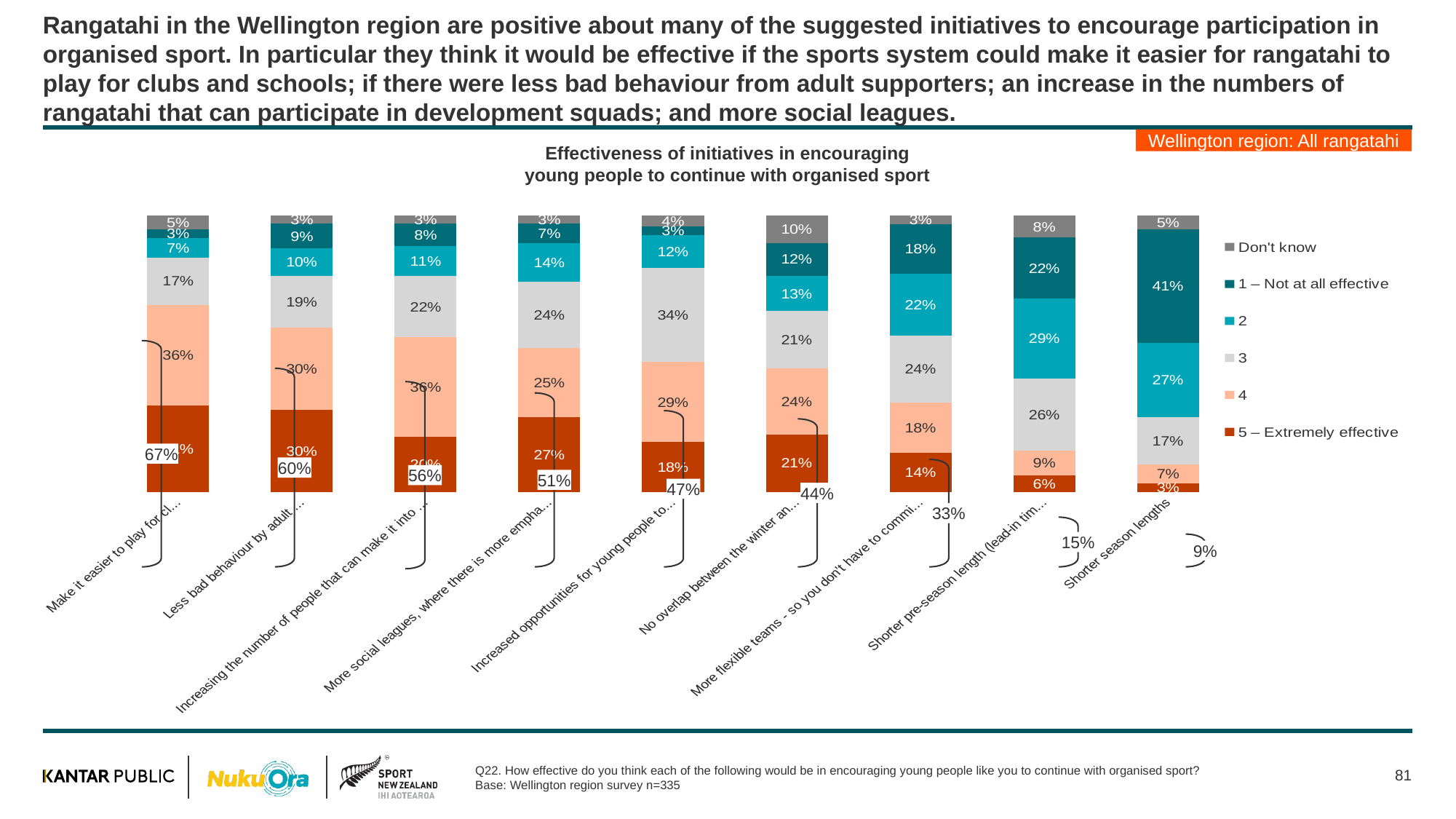
What is the value for rating '3' in the bar labelled 'Increased opportunities for young people to...'? 34% What is the value for rating '2' in the 'Shorter season lengths' bar? 27% In the 'Shorter season lengths' bar, what is the difference between the '1 – Not at all effective' value and the rating '2' value? 14 percentage points What type of chart is shown on the slide? Stacked bar chart What is the value for rating '3' in the 'Shorter pre-season length' bar? 26% Which initiative has the highest '1 – Not at all effective' value? Shorter season lengths How many initiatives (bars) are plotted in the chart? 9 What is the 'Don't know' value for the bar labelled 'No overlap between the winter an...'? 10% In the 'Shorter season lengths' bar, which is larger: the value for rating '3' or rating '4'? Rating 3 How many series does the legend list? 6 What is the title of the chart? Effectiveness of initiatives in encouraging young people to continue with organised sport What is the '1 – Not at all effective' value for 'Shorter season lengths'? 41%